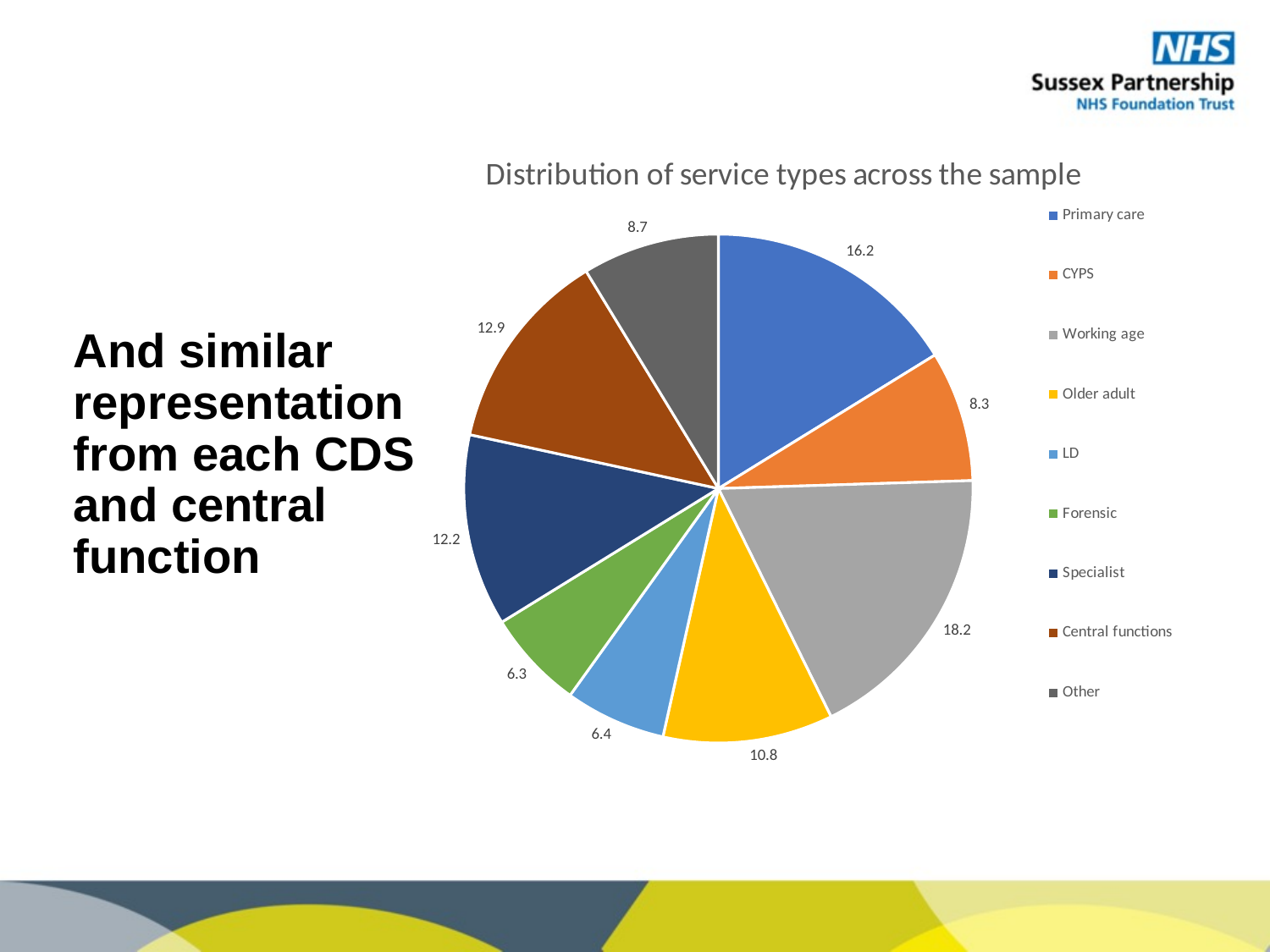
Which legend entry is shown in orange? CYPS What type of chart is shown on the slide? Pie chart What is the value for Central functions? 12.9 What is the value for Working age? 18.2 What is the value for Primary care? 16.2 How many service types are shown in the pie chart? 9 What is the title of the chart? Distribution of service types across the sample Which service type has the largest slice of the pie? Working age Which is larger, the value for Specialist or the value for Older adult? Specialist What is the value for LD? 6.4 Which service type has the smallest slice of the pie? Forensic What is the difference between the values for Working age and Primary care? 2.0